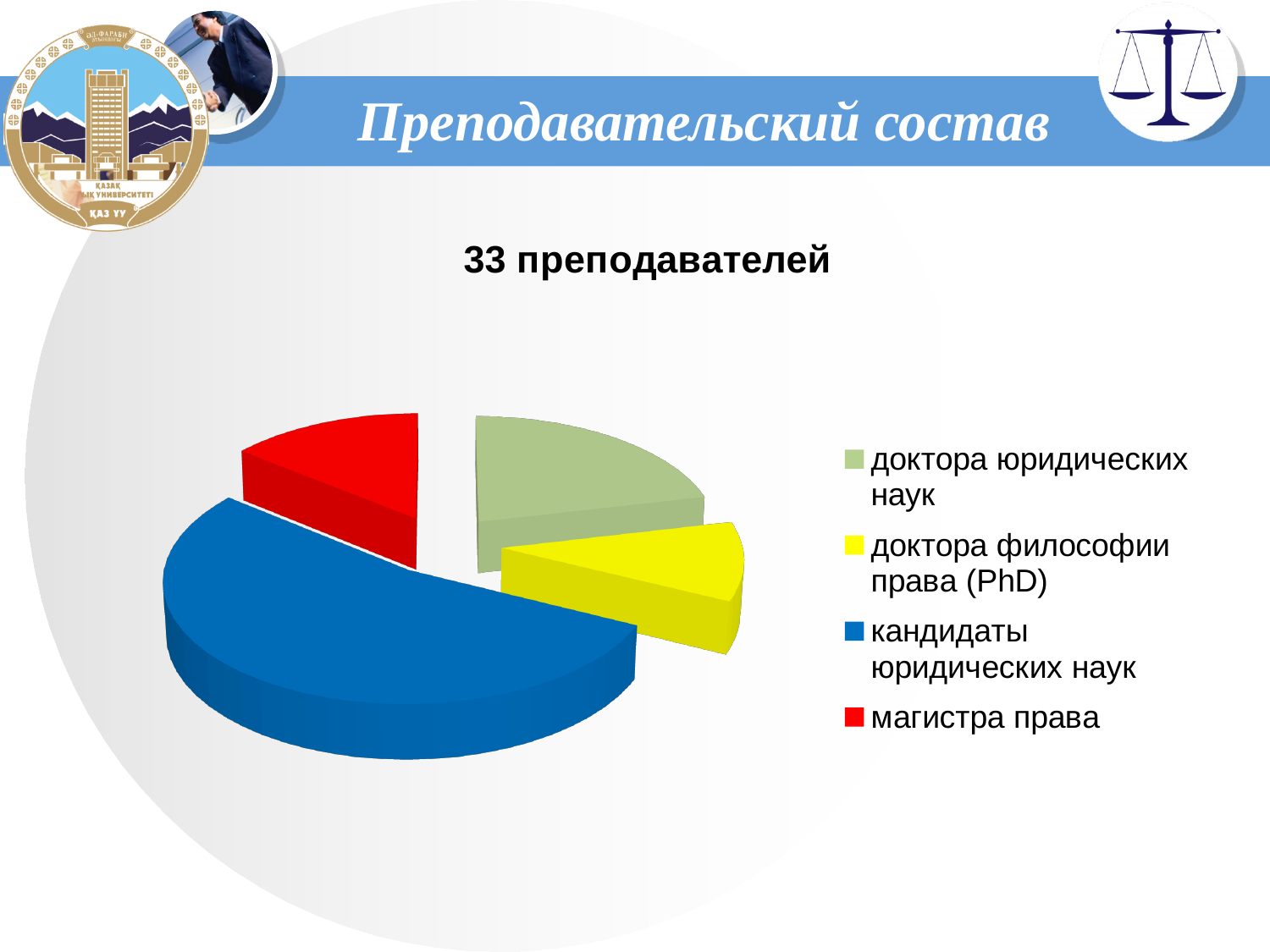
What kind of chart is shown on the slide? pie chart How many entries does the legend of the pie chart list? 4 What colour is the slice for магистра права? red Which slice is larger: кандидаты юридических наук or доктора философии права (PhD)? кандидаты юридических наук What is the title shown above the pie chart? 33 преподавателей Is the share of кандидаты юридических наук greater or less than 50% of the pie? greater Which category has the largest slice in the pie chart? кандидаты юридических наук How many categories (slices) does the pie chart have? 4 Which slice is larger: кандидаты юридических наук or магистра права? кандидаты юридических наук Which category is shown in yellow in the pie chart? доктора философии права (PhD)